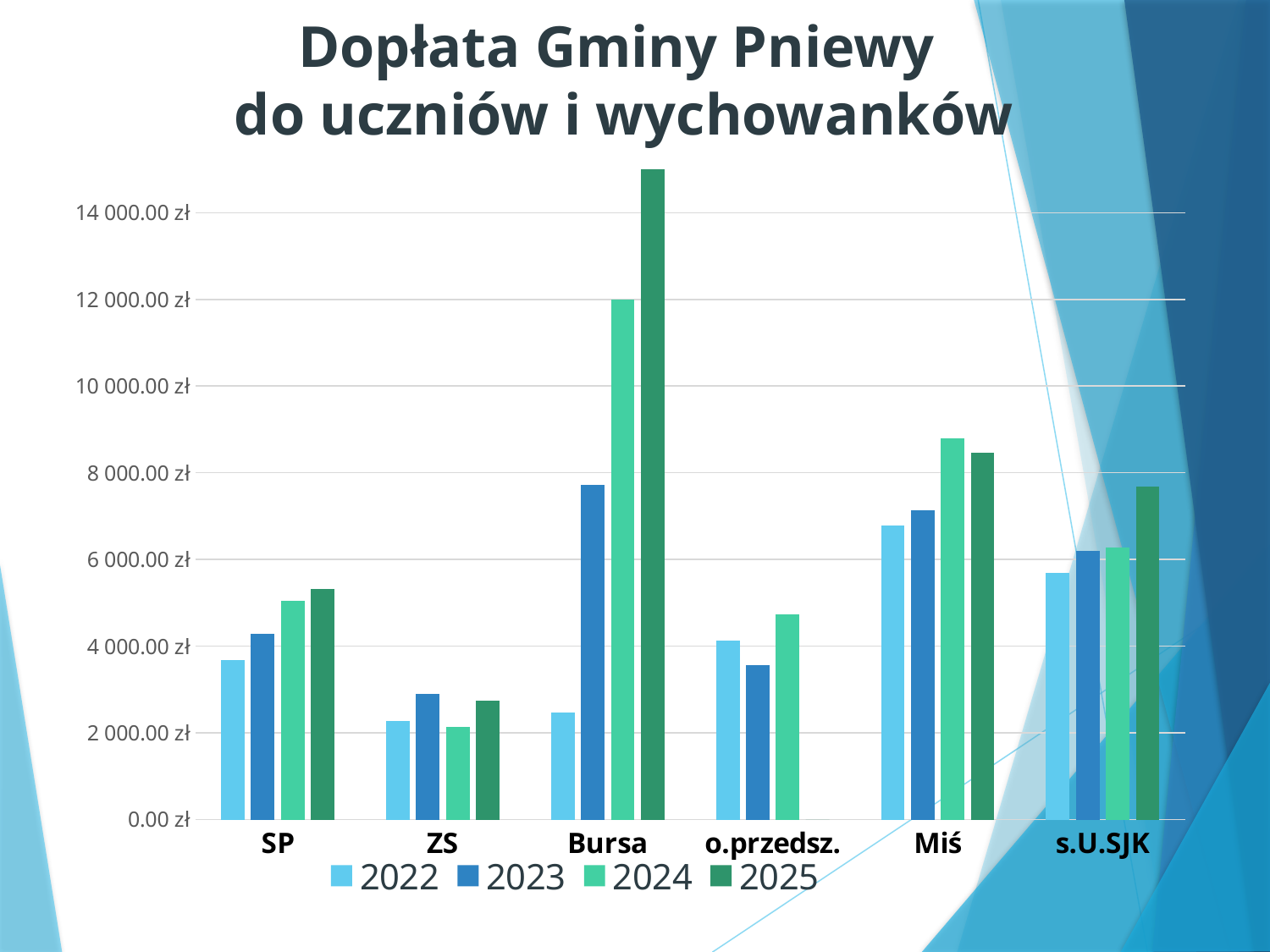
Is the value for Miś in 2024 greater or less than 8 000.00 zł? greater Is the value for Bursa in 2025 greater or less than 14 000.00 zł? greater Which category has the highest bar in the chart? Bursa How many series does the legend list? 4 How many categories are shown on the x axis? 6 Which category has no bar for 2025? o.przedsz. Do the values for Bursa rise or fall from 2022 to 2025? rise Is the value for o.przedsz. in 2023 greater or less than 4 000.00 zł? less Which category has the highest value for 2022? Miś Which is larger, the 2025 value for SP or the 2025 value for ZS? SP What kind of chart is shown on the slide? bar chart